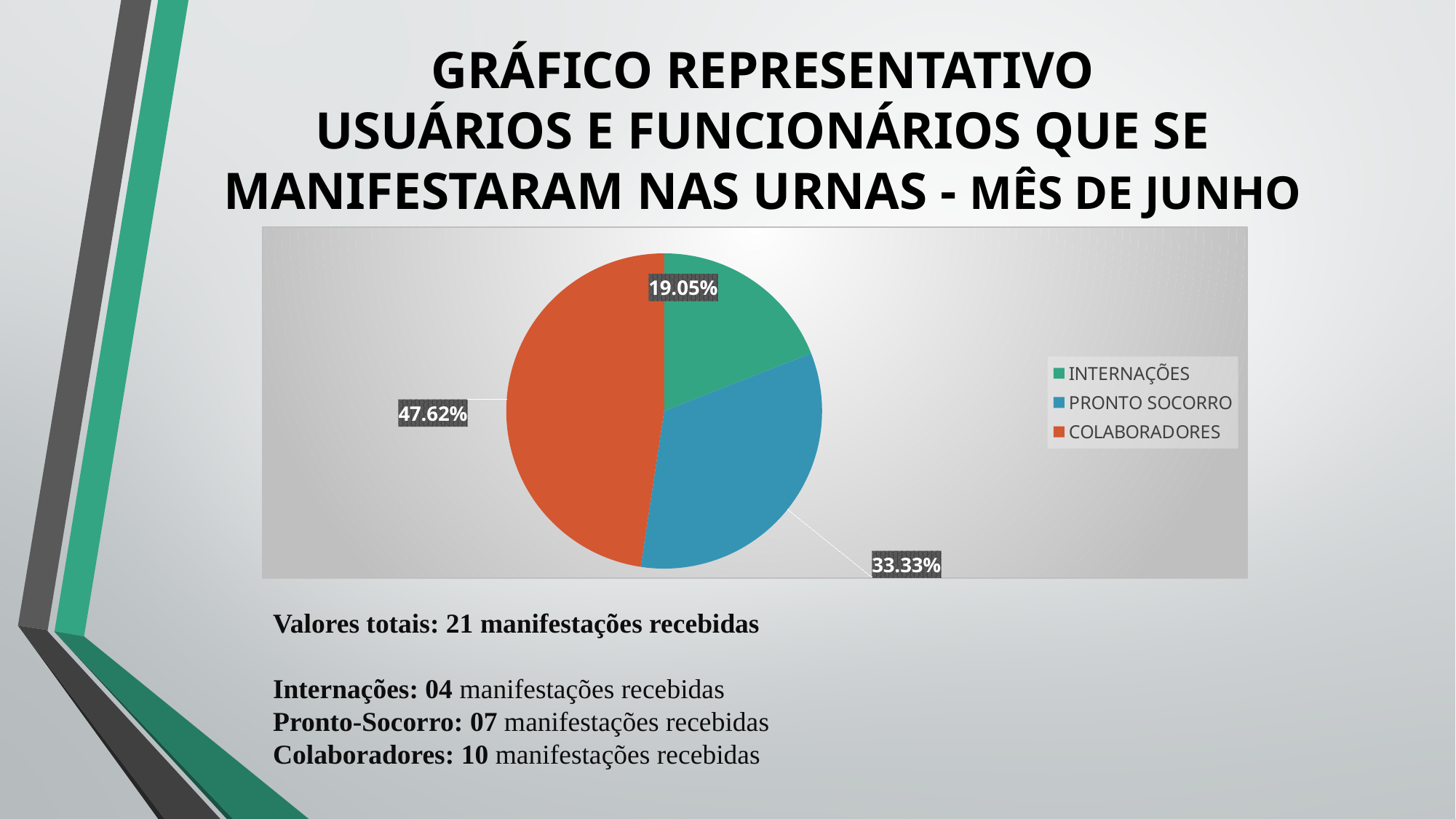
How many entries does the legend list? 3 Which category has the smallest slice of the pie? INTERNAÇÕES What is the difference in percentage points between the COLABORADORES slice and the PRONTO SOCORRO slice? 14.29 What kind of chart is shown on the slide? pie chart What share of the pie does PRONTO SOCORRO represent? 33.33% Which slice is larger, PRONTO SOCORRO or INTERNAÇÕES? PRONTO SOCORRO What share of the pie does INTERNAÇÕES represent? 19.05% Which category has the largest slice of the pie? COLABORADORES What colour is the COLABORADORES slice in the pie chart? orange What share of the pie does COLABORADORES represent? 47.62% How many slices does the pie chart have? 3 What is the difference in percentage points between the PRONTO SOCORRO slice and the INTERNAÇÕES slice? 14.28